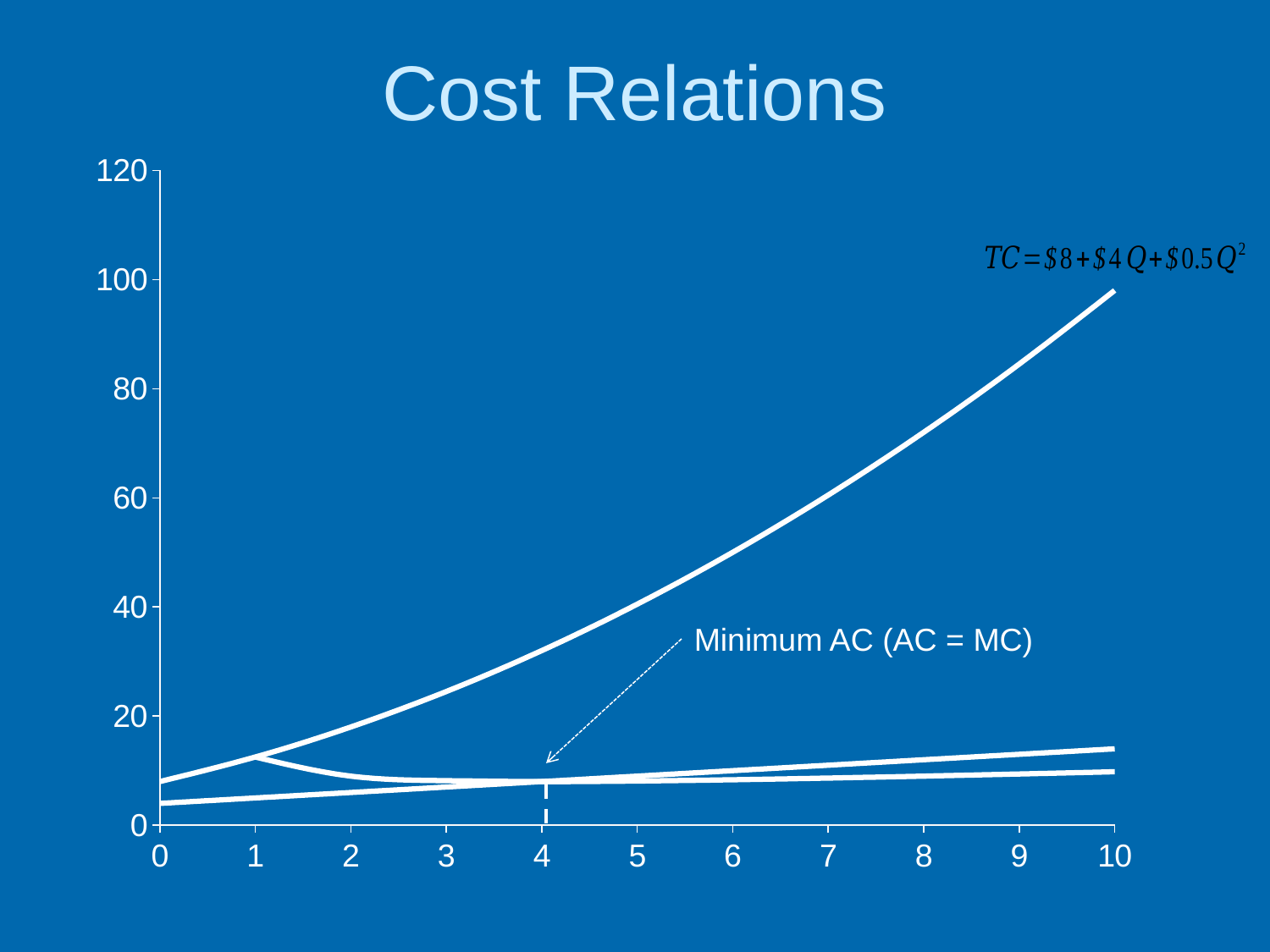
Is the value of the TC curve at a quantity of 3 greater or less than 20? greater How many curves are plotted on the chart? 3 Is the value of the TC curve at a quantity of 6 greater or less than 40? greater Is the value of the TC curve at a quantity of 10 greater or less than 80? greater What is the title of the chart? Cost Relations What is the highest value shown on the vertical axis? 120 At what quantity does the dashed vertical line mark the minimum AC (AC = MC)? 4 Does the total cost (TC) curve rise or fall as quantity increases from 0 to 10? rise What equation for total cost is printed on the chart? TC = $8 + $4Q + $0.5Q² What is the largest quantity shown on the horizontal axis? 10 What kind of chart is shown on the slide? line chart